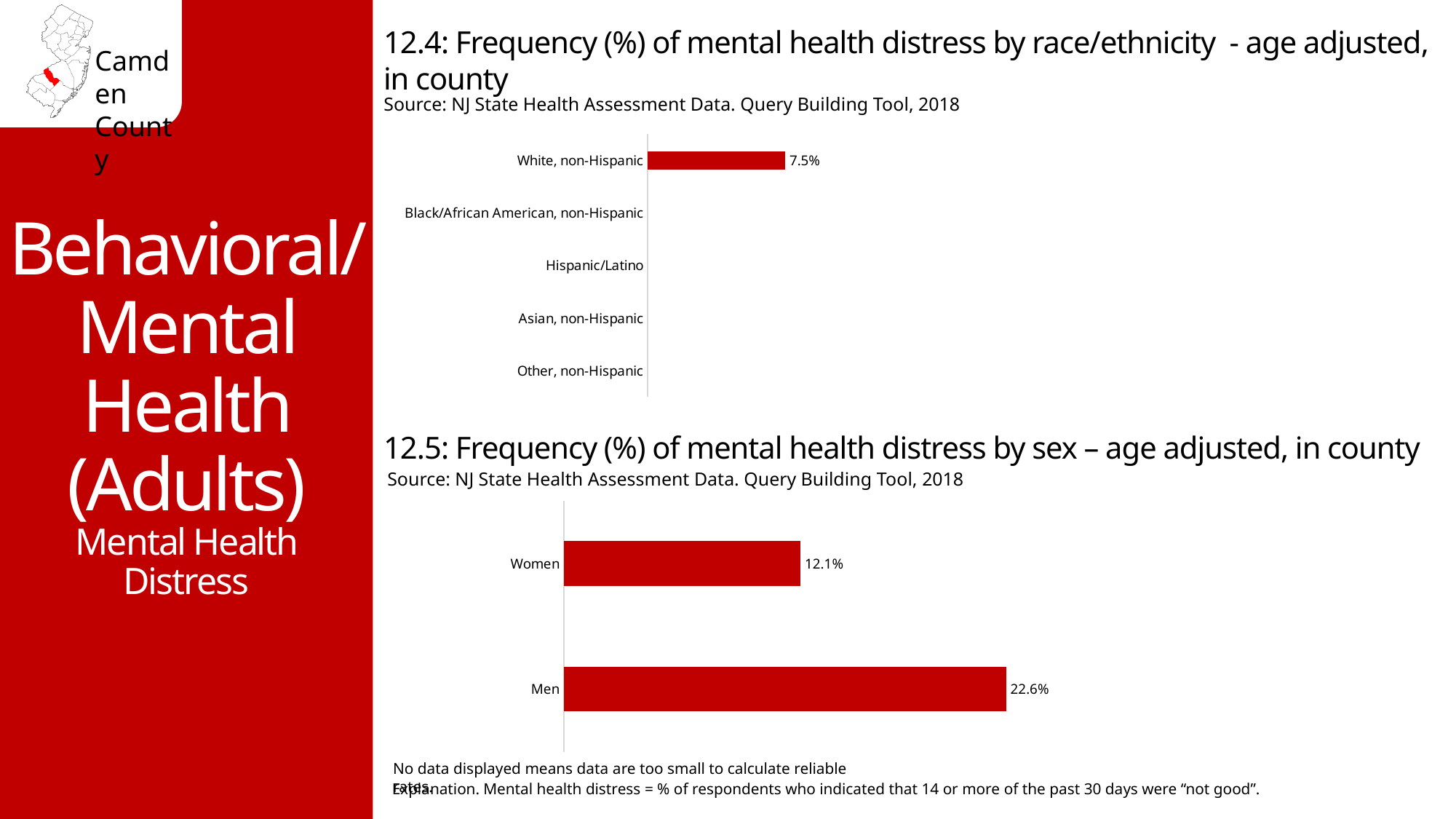
What kind of chart is chart 12.4 (mental health distress by race/ethnicity)? Bar chart In the chart 12.5 (mental health distress by sex), which category has the lowest value? Women In the chart 12.5 (mental health distress by sex), what is the value for Women? 12.1% In the chart 12.4 (mental health distress by race/ethnicity), how many race/ethnicity categories are listed on the axis? 5 In the chart 12.5 (mental health distress by sex), what is the value for Men? 22.6% What kind of chart is chart 12.5 (mental health distress by sex)? Bar chart In the chart 12.5 (mental health distress by sex), is the value for Men larger or smaller than the value for Women? Larger In the chart 12.5 (mental health distress by sex), which category has the highest value? Men In the chart 12.4 (mental health distress by race/ethnicity), which category is the only one with a bar displayed? White, non-Hispanic In the chart 12.5 (mental health distress by sex), how many categories are shown? 2 In the chart 12.4 (mental health distress by race/ethnicity), what is the value for White, non-Hispanic? 7.5% In the chart 12.5 (mental health distress by sex), what is the difference between the values for Men and Women? 10.5%